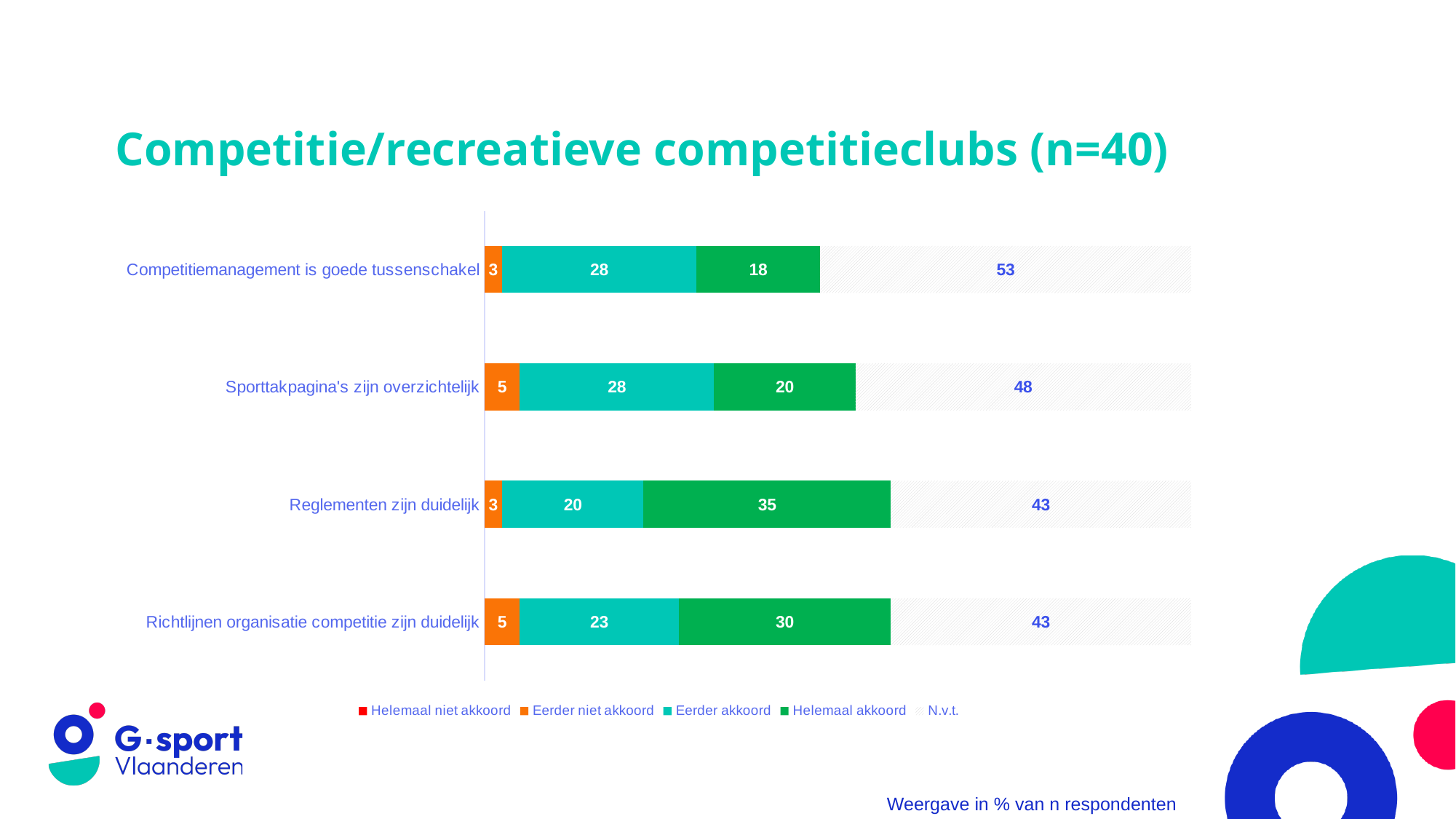
How many series does the legend list? 5 What is the value for 'Helemaal akkoord' in the 'Reglementen zijn duidelijk' bar? 35 Which category has the lowest 'Helemaal akkoord' value? Competitiemanagement is goede tussenschakel What kind of chart is shown on the slide? Stacked bar chart What is the difference between the 'Helemaal akkoord' values for 'Reglementen zijn duidelijk' and 'Richtlijnen organisatie competitie zijn duidelijk'? 5 What is the 'Eerder akkoord' value for 'Richtlijnen organisatie competitie zijn duidelijk'? 23 What is the difference between the 'N.v.t.' values for 'Competitiemanagement is goede tussenschakel' and 'Sporttakpagina's zijn overzichtelijk'? 5 What is the 'N.v.t.' value for 'Competitiemanagement is goede tussenschakel'? 53 How many categories (statements) are shown in the chart? 4 Which category has the highest 'Helemaal akkoord' value? Reglementen zijn duidelijk What is the 'Eerder niet akkoord' value for 'Sporttakpagina's zijn overzichtelijk'? 5 Which has the larger 'Eerder akkoord' value: 'Sporttakpagina's zijn overzichtelijk' or 'Richtlijnen organisatie competitie zijn duidelijk'? Sporttakpagina's zijn overzichtelijk